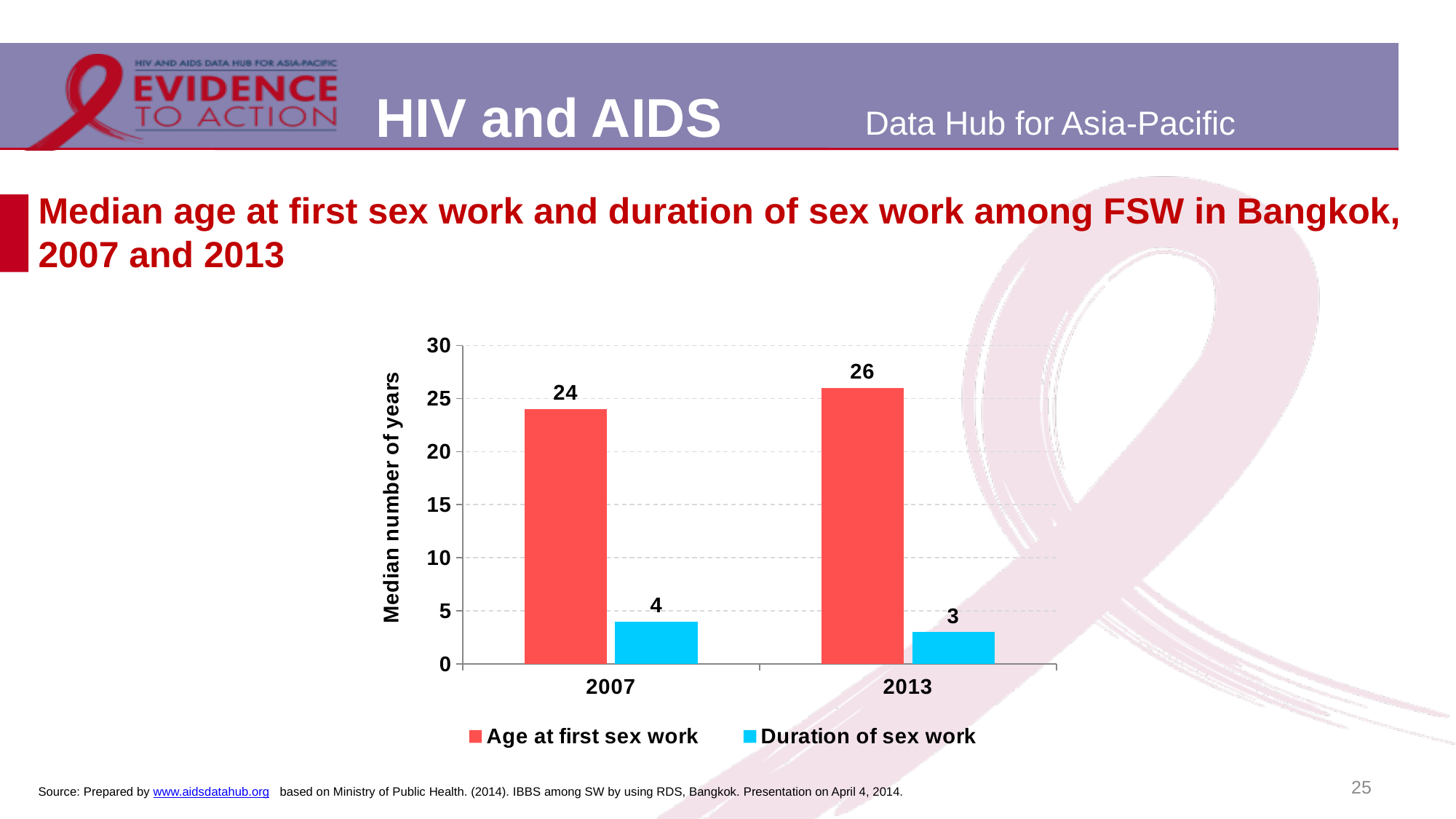
In which year was the median age at first sex work higher? 2013 What is the median duration of sex work among FSW in Bangkok in 2013? 3 What is the label of the vertical axis? Median number of years What is the difference between the median age at first sex work and the median duration of sex work in 2007? 20 What is the median age at first sex work among FSW in Bangkok in 2007? 24 What is the median age at first sex work in 2013? 26 How many series does the legend list? 2 Is the median duration of sex work in 2007 greater or less than the median duration in 2013? greater By how many years did the median age at first sex work increase from 2007 to 2013? 2 What type of chart is shown on the slide? Bar chart In which year was the median duration of sex work lower? 2013 What is the median duration of sex work in 2007? 4